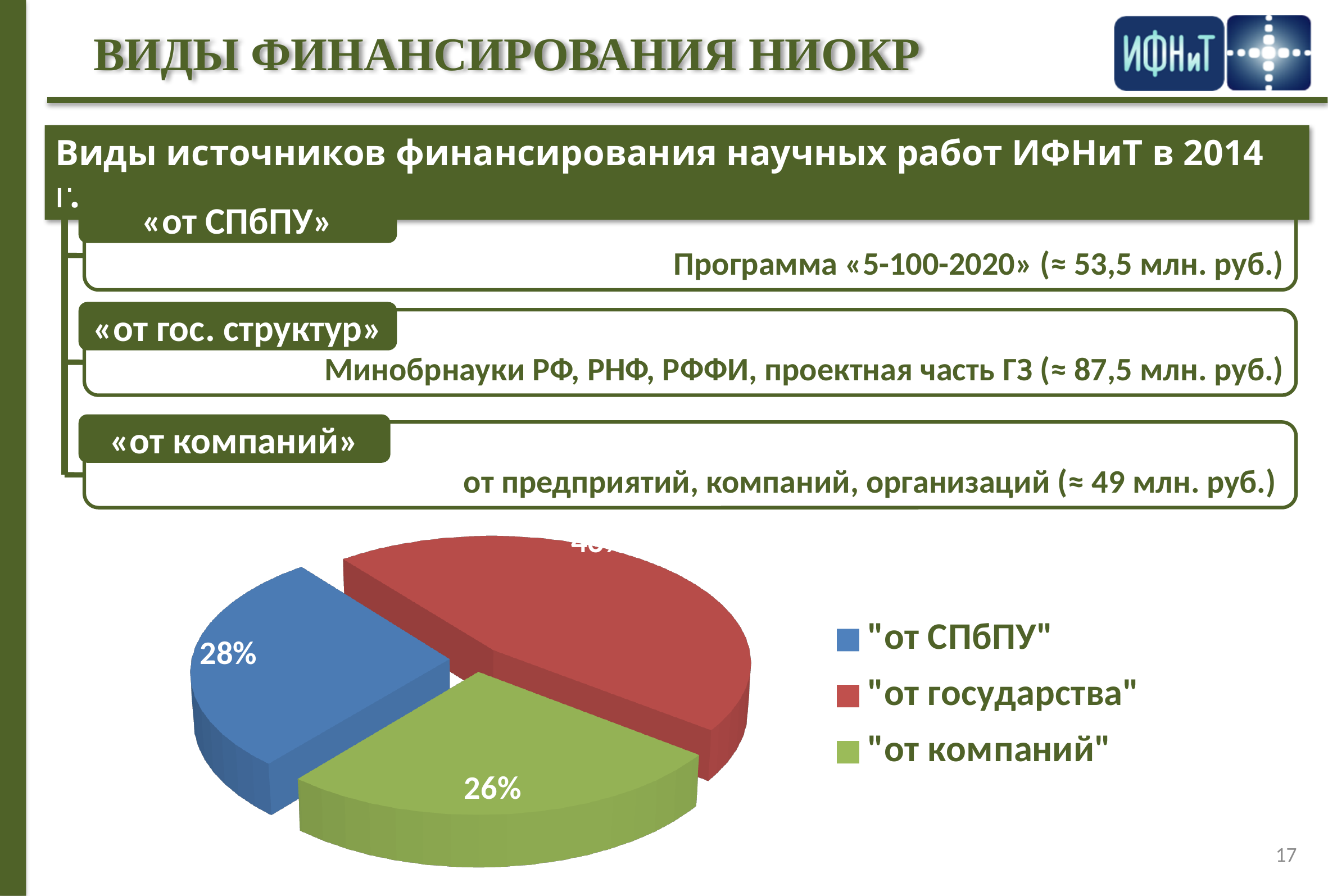
What percentage does the "от СПбПУ" slice of the pie chart represent? 28% How many entries does the legend of the pie chart list? 3 What type of chart is shown on the slide? Pie chart What colour is the "от СПбПУ" slice in the pie chart? Blue How many slices does the pie chart have? 3 Which slice is larger in the pie chart, "от СПбПУ" or "от компаний"? "от СПбПУ" What colour is the "от государства" slice in the pie chart? Red What percentage does the "от компаний" slice of the pie chart represent? 26% Which funding source has the largest slice in the pie chart? "от государства" Which funding source has the smallest slice in the pie chart? "от компаний" By how many percentage points does the "от СПбПУ" slice exceed the "от компаний" slice? 2